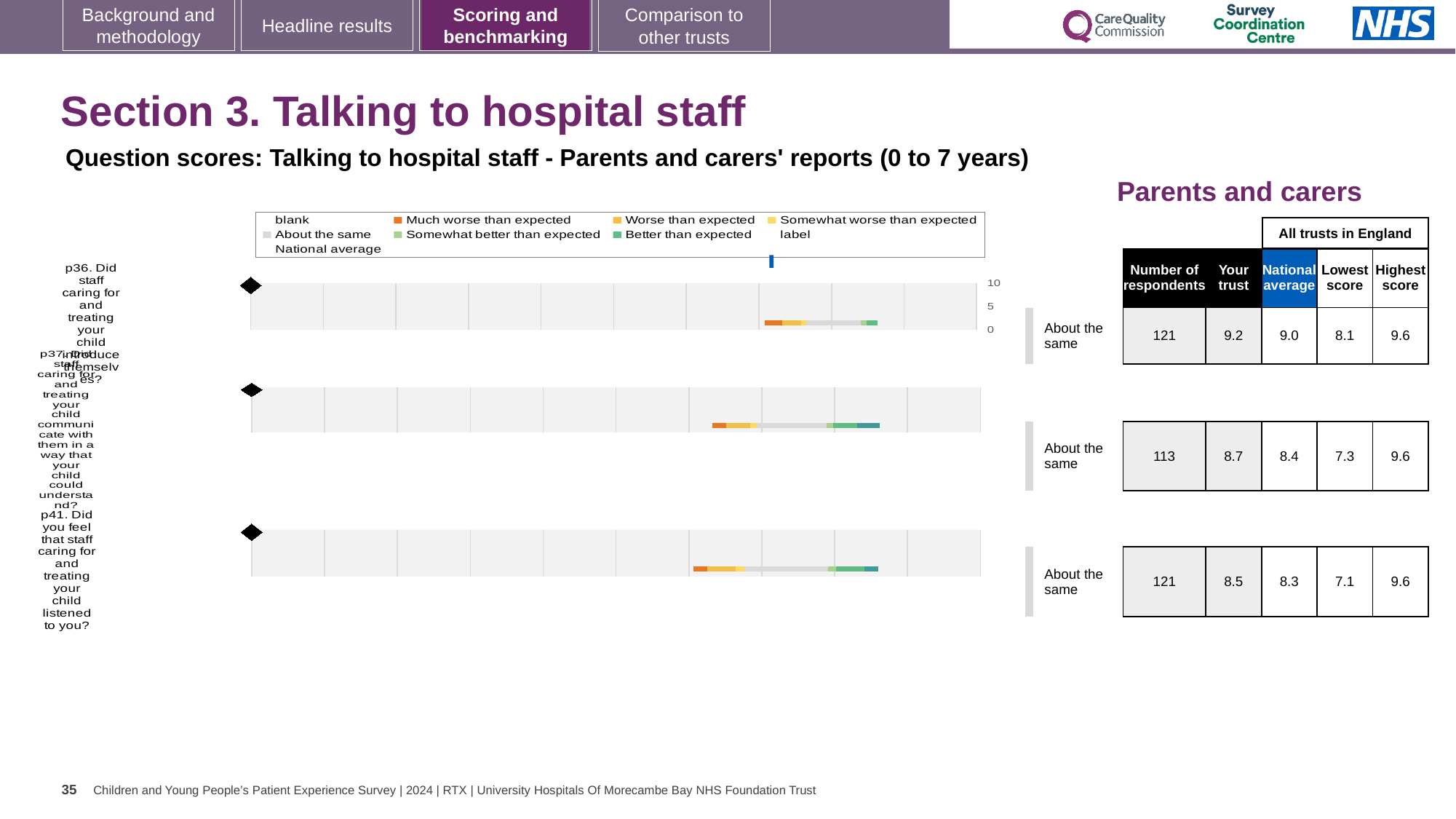
What kind of chart is used to show the question scores on this slide? bar chart Which question has the highest 'Your trust' score? p36 For p36, which is larger: the 'Your trust' score or the national average? Your trust How many question rows (charts) are shown on the slide? 3 What is the 'Your trust' score for p36 (Did staff caring for and treating your child introduce themselves?)? 9.2 What is the national average score for p37 (Did staff communicate with your child in a way they could understand?)? 8.4 What is the maximum value shown on the chart's score axis? 10 What is the difference between the 'Your trust' score and the national average for p37? 0.3 What is the highest score among all trusts in England for p41? 9.6 Which question has the lowest 'Your trust' score? p41 What benchmark category label is shown next to each of the three question rows? About the same How many respondents answered p41 (Did you feel that staff listened to you?)? 121